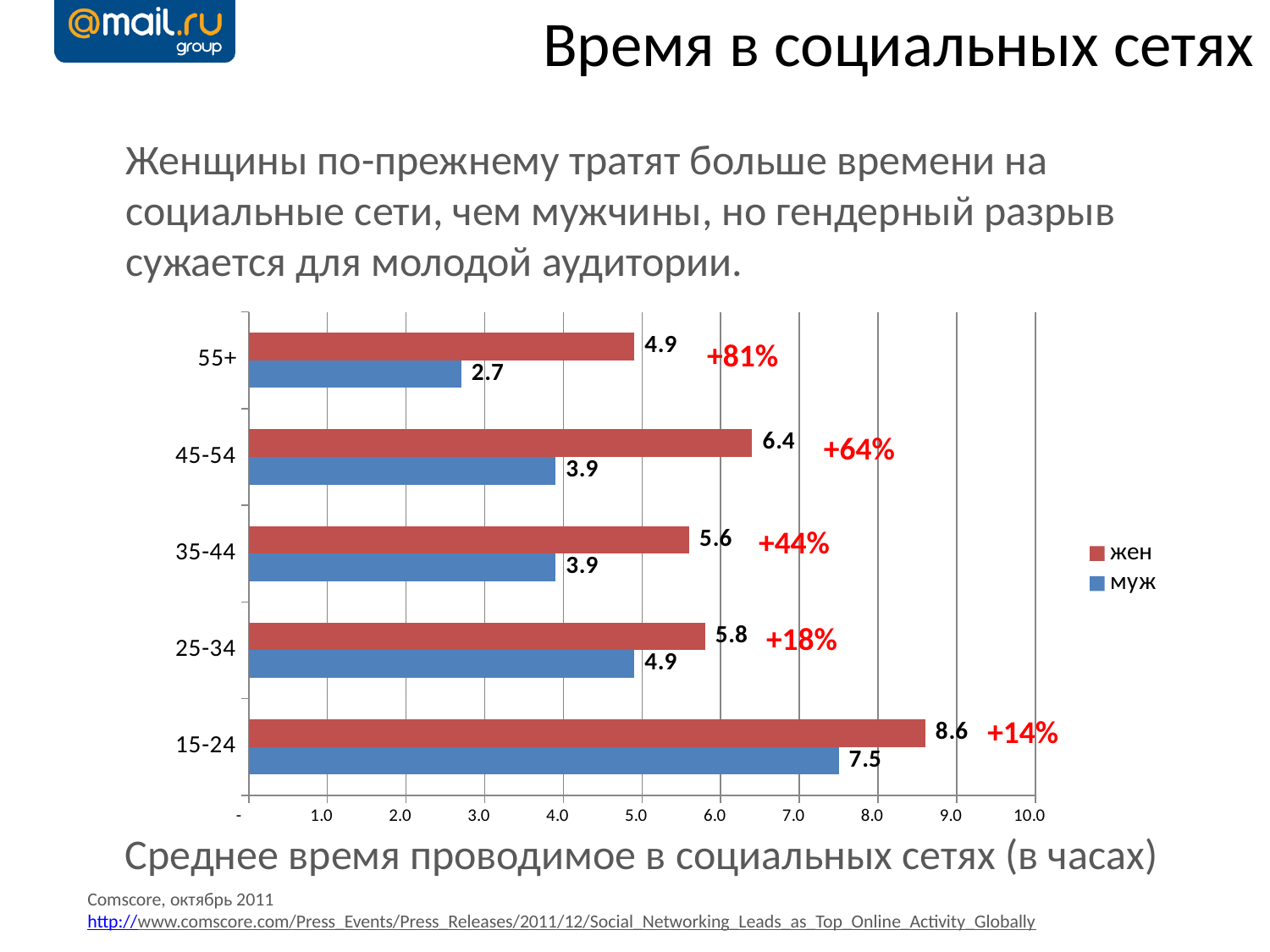
Which is larger in the 25-34 age group, the value for жен or for муж? жен Is the value for муж in the 15-24 age group greater or less than 7.0? greater What percentage label is shown next to the 55+ age group bars? +81% What is the difference between the жен and муж values in the 45-54 age group? 2.5 Which age group has the highest value for муж? 15-24 Which age group has the lowest value for жен? 55+ What is the value for жен in the 15-24 age group? 8.6 What is the value for жен in the 45-54 age group? 6.4 How many age groups are shown on the chart? 5 How many series does the legend list? 2 What kind of chart is shown on the slide? bar chart What is the value for муж in the 55+ age group? 2.7